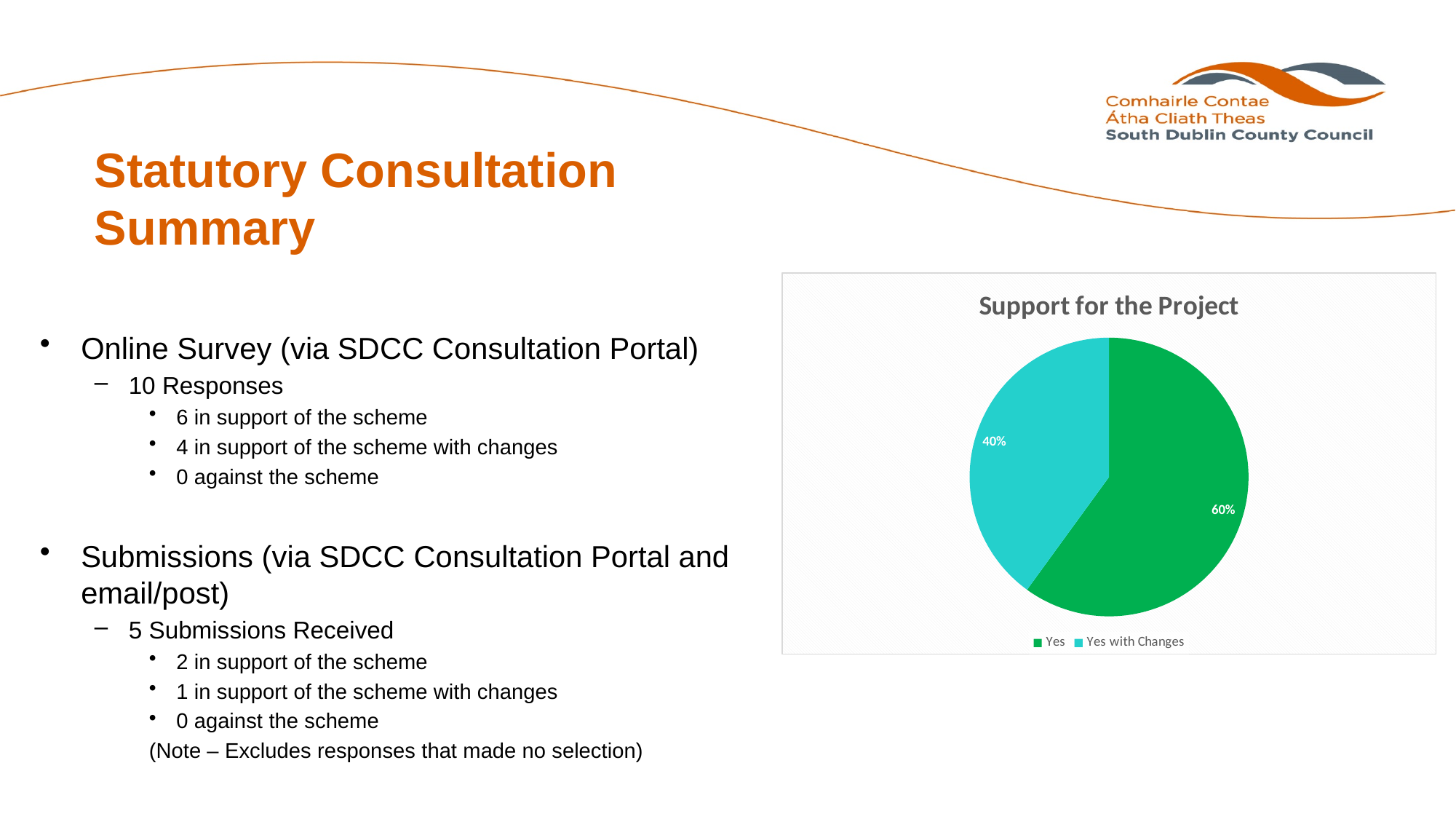
What share of the pie does the 'Yes' slice represent? 60% Which slice of the pie is the smallest? Yes with Changes What is the title of the chart? Support for the Project Which legend entry is shown in the lighter teal colour? Yes with Changes What share of the pie does the 'Yes with Changes' slice represent? 40% Is the share for 'Yes' greater or less than 50%? greater What kind of chart is shown on the slide? pie chart Which slice of the pie is the largest? Yes How many slices does the pie chart have? 2 How many entries does the chart legend list? 2 What is the difference in percentage points between the 'Yes' and 'Yes with Changes' slices? 20 percentage points Which is larger: the 'Yes' slice or the 'Yes with Changes' slice? Yes